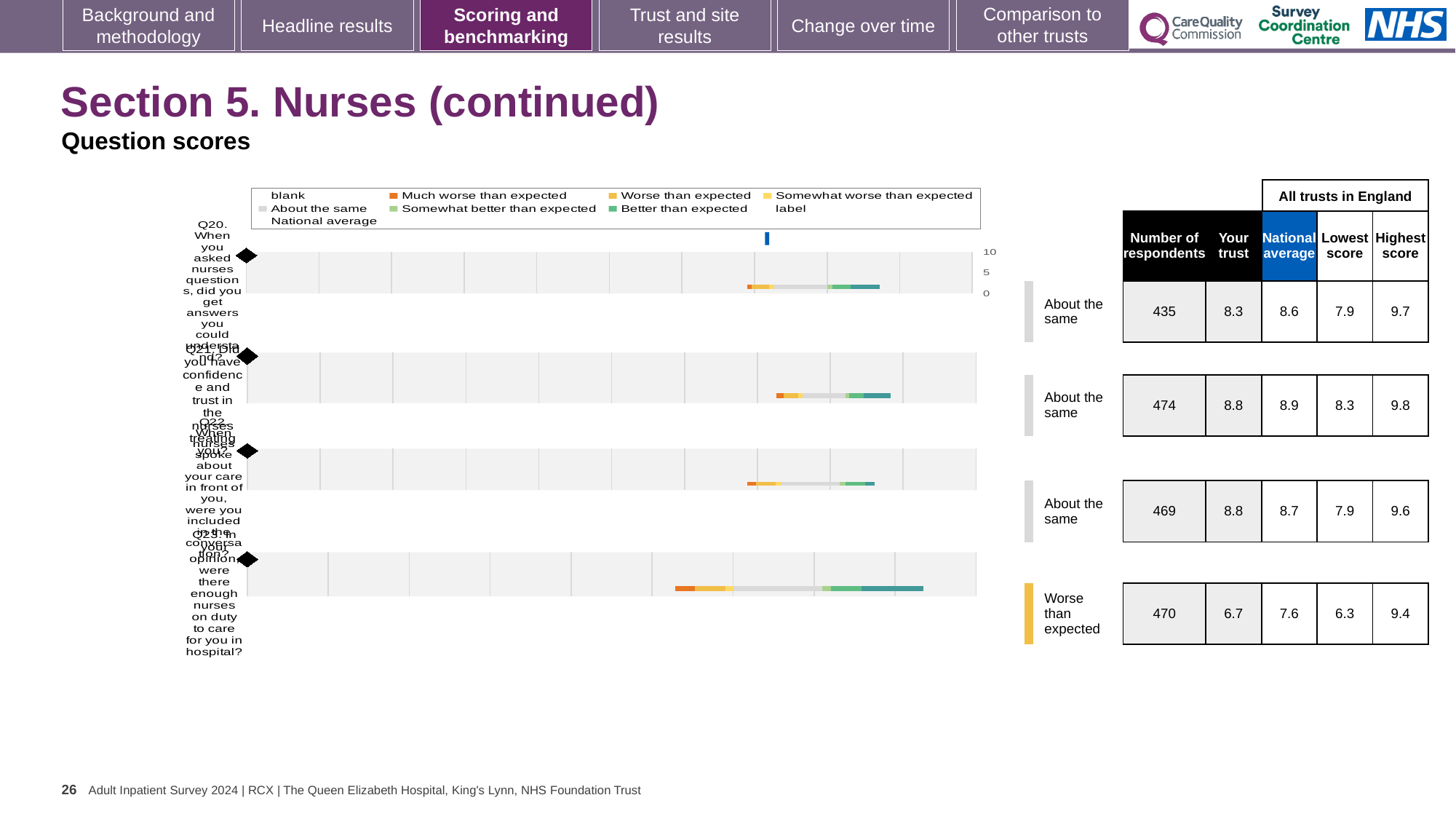
How many respondents answered Q21? 474 Which question has the highest 'Highest score' across all trusts in England? Q21 What is the difference between the national average and the 'Your trust' score for Q23? 0.9 What kind of chart is used to show the question scores for Q20 to Q23? Bar chart How many entries does the chart legend list? 9 What is the 'Your trust' score for Q23 (were there enough nurses on duty)? 6.7 What is the national average score for Q20? 8.6 For Q22, which is larger: the 'Your trust' score or the national average? Your trust How many questions (bars) are plotted in the chart? 4 Which question has the lowest 'Your trust' score? Q23 Which question is rated 'Worse than expected'? Q23 What colour represents 'Much worse than expected' in the legend? Orange